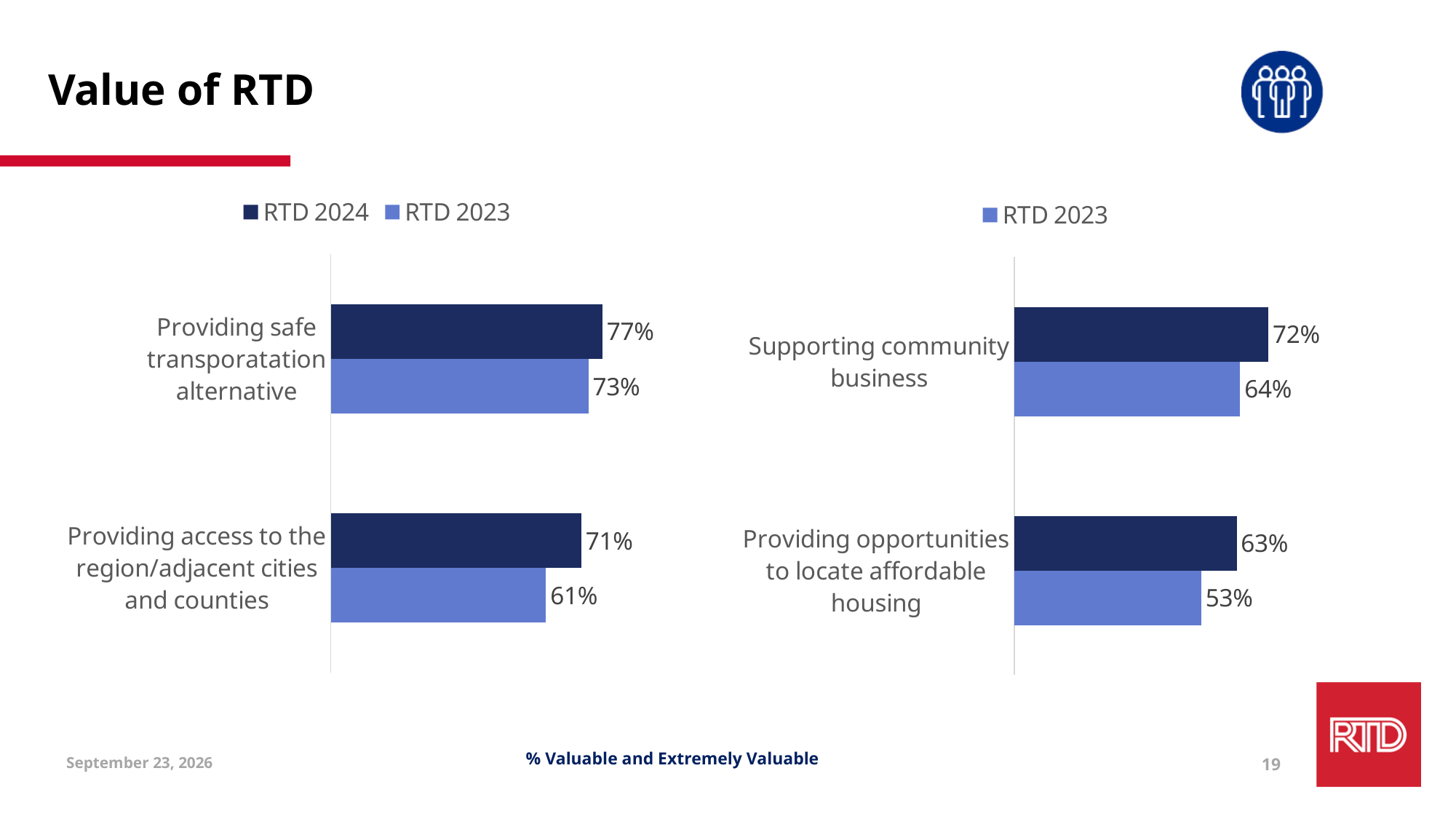
In the left chart, is the RTD 2023 value for Providing safe transportation alternative larger or smaller than the RTD 2024 value for Providing access to the region/adjacent cities and counties? larger In the right chart, what value does the dark blue bar show for Providing opportunities to locate affordable housing? 63% What type of chart is the left chart? Bar chart How many categories are shown in the right chart? 2 In the right chart, which category has the lowest RTD 2023 value? Providing opportunities to locate affordable housing In the left chart, what is the RTD 2024 value for Providing safe transportation alternative? 77% In the left chart, what is the difference between the RTD 2024 and RTD 2023 values for Providing access to the region/adjacent cities and counties? 10 percentage points In the left chart, what is the RTD 2023 value for Providing access to the region/adjacent cities and counties? 61% How many series does the legend of the left chart list? 2 In the right chart, what is the RTD 2023 value for Supporting community business? 64% In the left chart, which category has the highest RTD 2024 value? Providing safe transportation alternative In the right chart, what is the difference between the dark blue bar and the RTD 2023 bar for Supporting community business? 8 percentage points